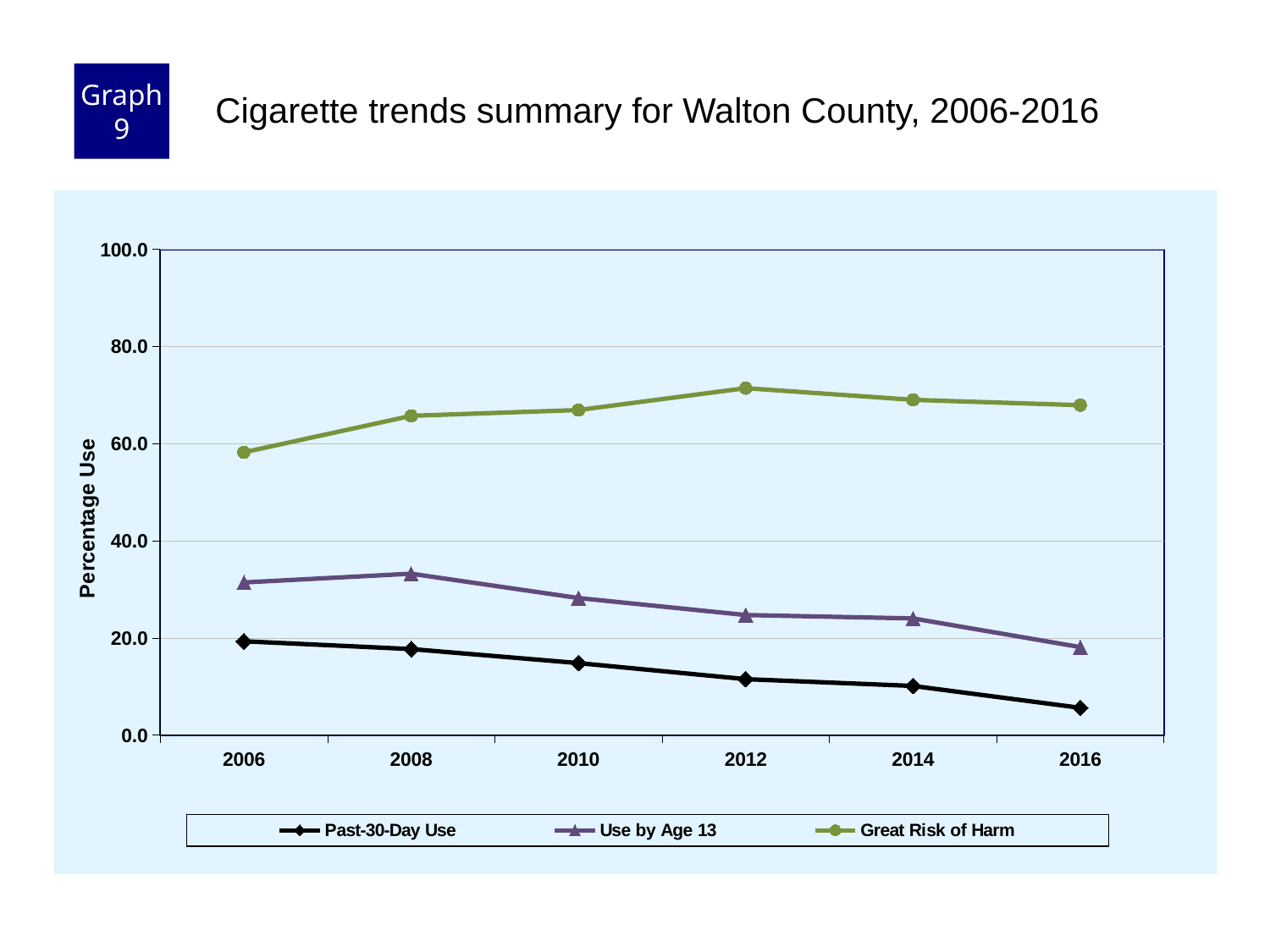
Is the value for Great Risk of Harm in 2012 greater or less than 60.0? greater What is the label on the y axis? Percentage Use How many years are plotted along the x axis? 6 In which year is Use by Age 13 at its lowest? 2016 In 2006, which is larger: Use by Age 13 or Past-30-Day Use? Use by Age 13 Is the value for Great Risk of Harm in 2006 greater or less than 60.0? less Does the Past-30-Day Use series rise or fall from 2006 to 2016? Fall Is the value for Past-30-Day Use in 2016 greater or less than 10.0? less In which year is Past-30-Day Use at its lowest? 2016 How many series does the legend list? 3 What kind of chart is shown on the slide? Line chart In which year is Great Risk of Harm at its highest? 2012